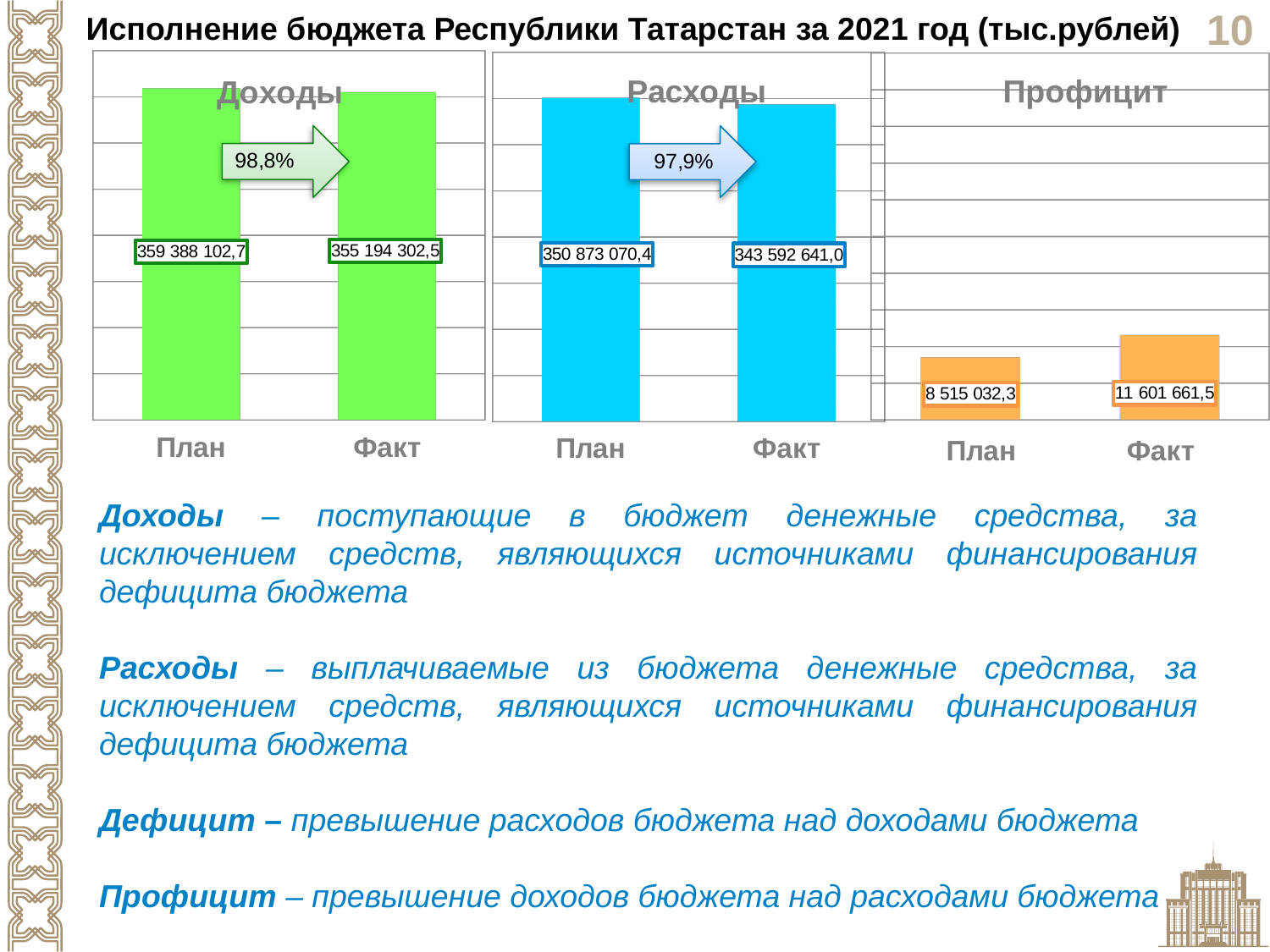
In the Доходы chart, what is the value for Факт? 355 194 302,5 In the Профицит chart, which category has the higher value, План or Факт? Факт In the Профицит chart, what is the value for Факт? 11 601 661,5 In the Профицит chart, what is the difference between Факт and План? 3 086 629,2 In the Расходы chart, what is the difference between План and Факт? 7 280 429,4 What kind of chart is the Расходы chart? bar chart In the Доходы chart, what percentage is shown on the arrow between План and Факт? 98,8% In the Расходы chart, what is the value for План? 350 873 070,4 In the Профицит chart, what is the value for План? 8 515 032,3 In the Расходы chart, what is the value for Факт? 343 592 641,0 In the Доходы chart, what is the value for План? 359 388 102,7 How many categories are shown in the Профицит chart? 2